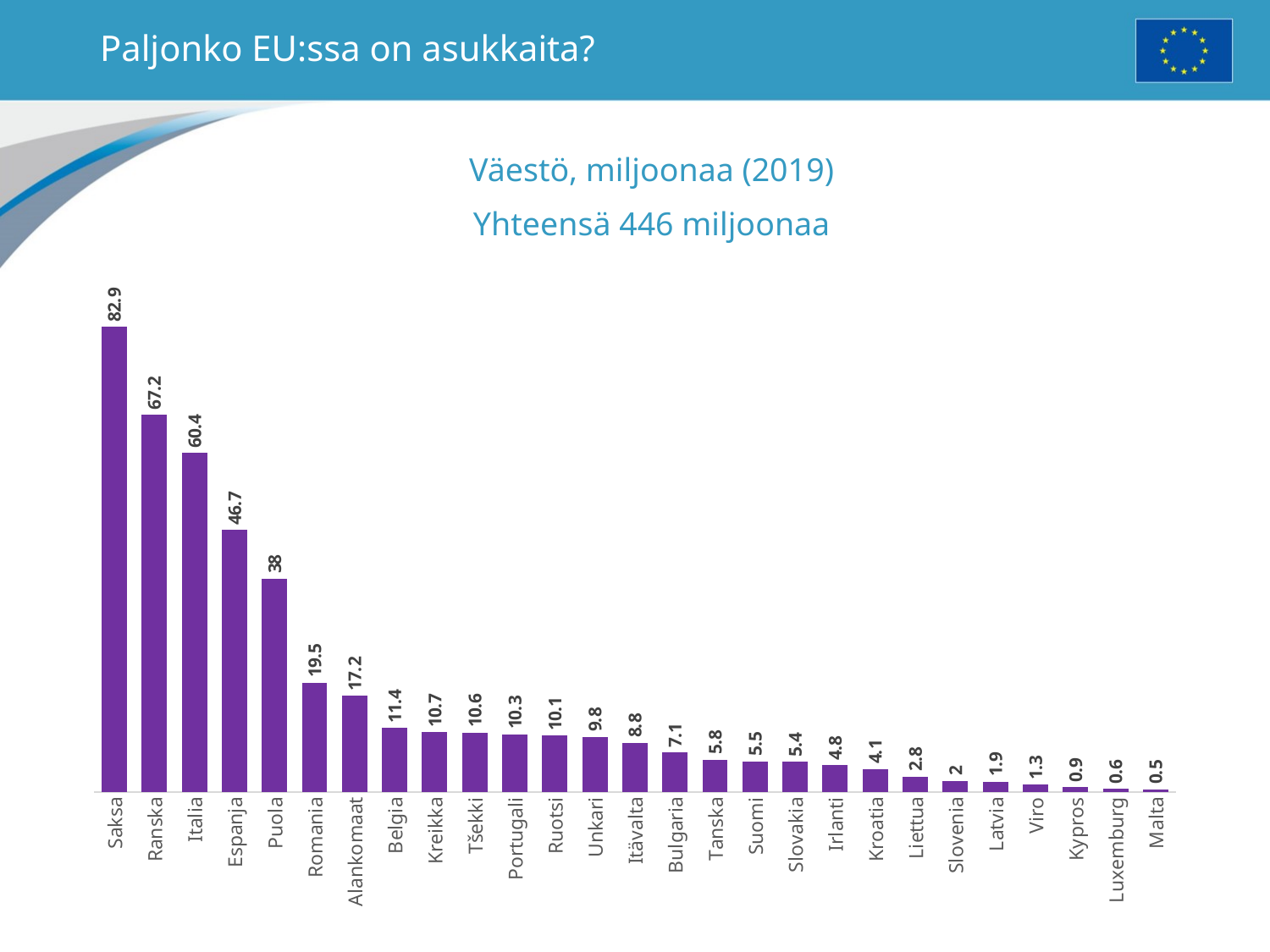
What is the value shown for Luxemburg? 0.6 What is the value shown for Saksa? 82.9 What is the difference between the values for Ranska and Italia? 6.8 What kind of chart is shown on the slide? Bar chart Do the values rise or fall from left to right along the x axis? Fall Which country has the highest value in the chart? Saksa Which country has the lowest value in the chart? Malta What is the value shown for Suomi? 5.5 What is the value shown for Puola? 38 How many countries are shown in the chart? 27 What is the difference between the values for Saksa and Espanja? 36.2 Which has a larger value, Romania or Alankomaat? Romania